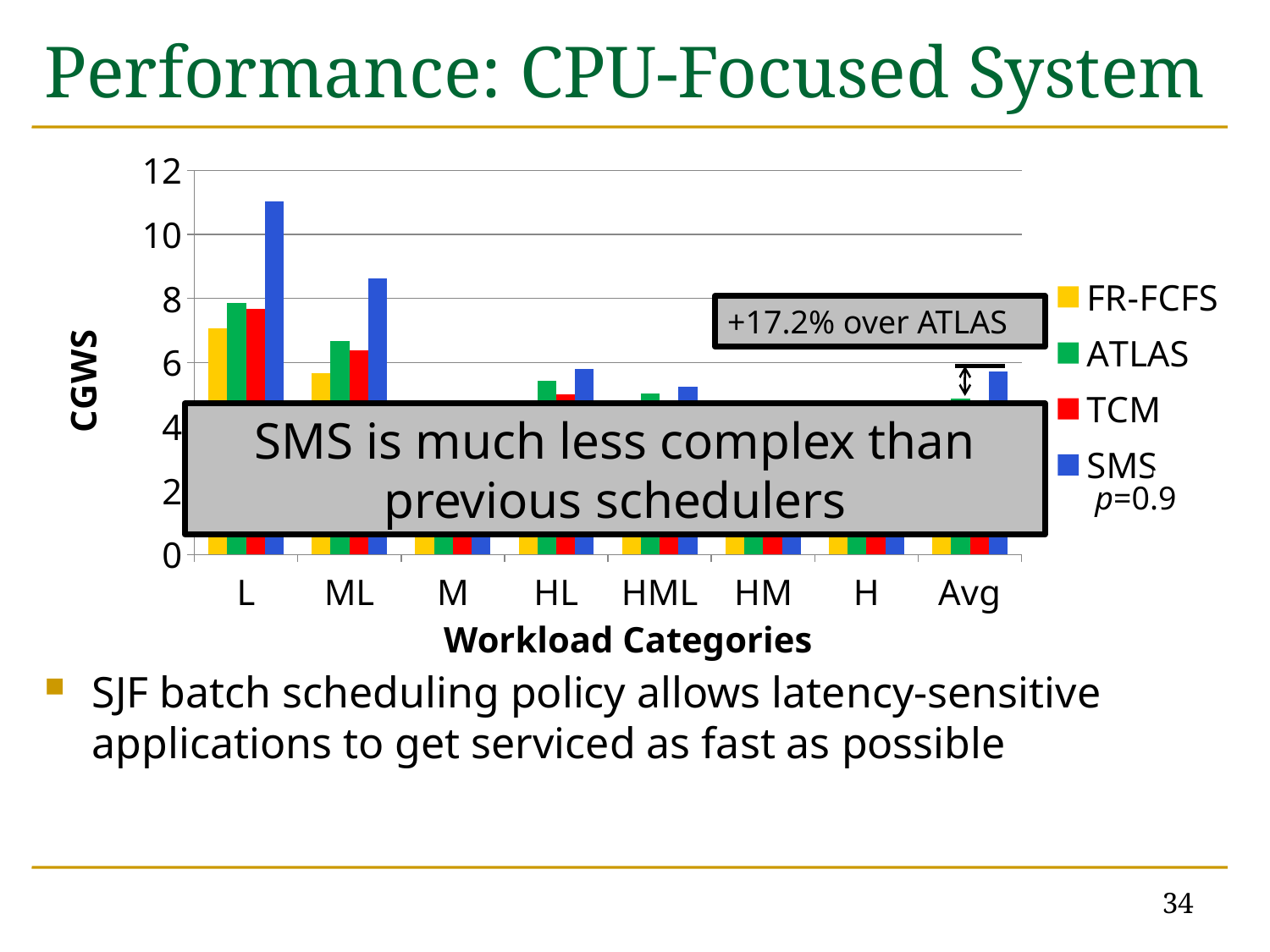
Is the SMS value for workload category L greater or less than 10? greater For workload category L, which is larger: the SMS value or the ATLAS value? SMS How many workload categories are shown on the x axis? 8 What improvement over ATLAS does the annotation on the chart state? +17.2% What kind of chart is shown on the slide? bar chart What is the label on the y axis of the chart? CGWS How many series does the legend list? 4 Is the FR-FCFS value for workload category ML greater or less than 6? less Is the SMS value for workload category ML greater or less than 8? greater Which series has the highest value for workload category ML? SMS Which series has the highest value for workload category L? SMS